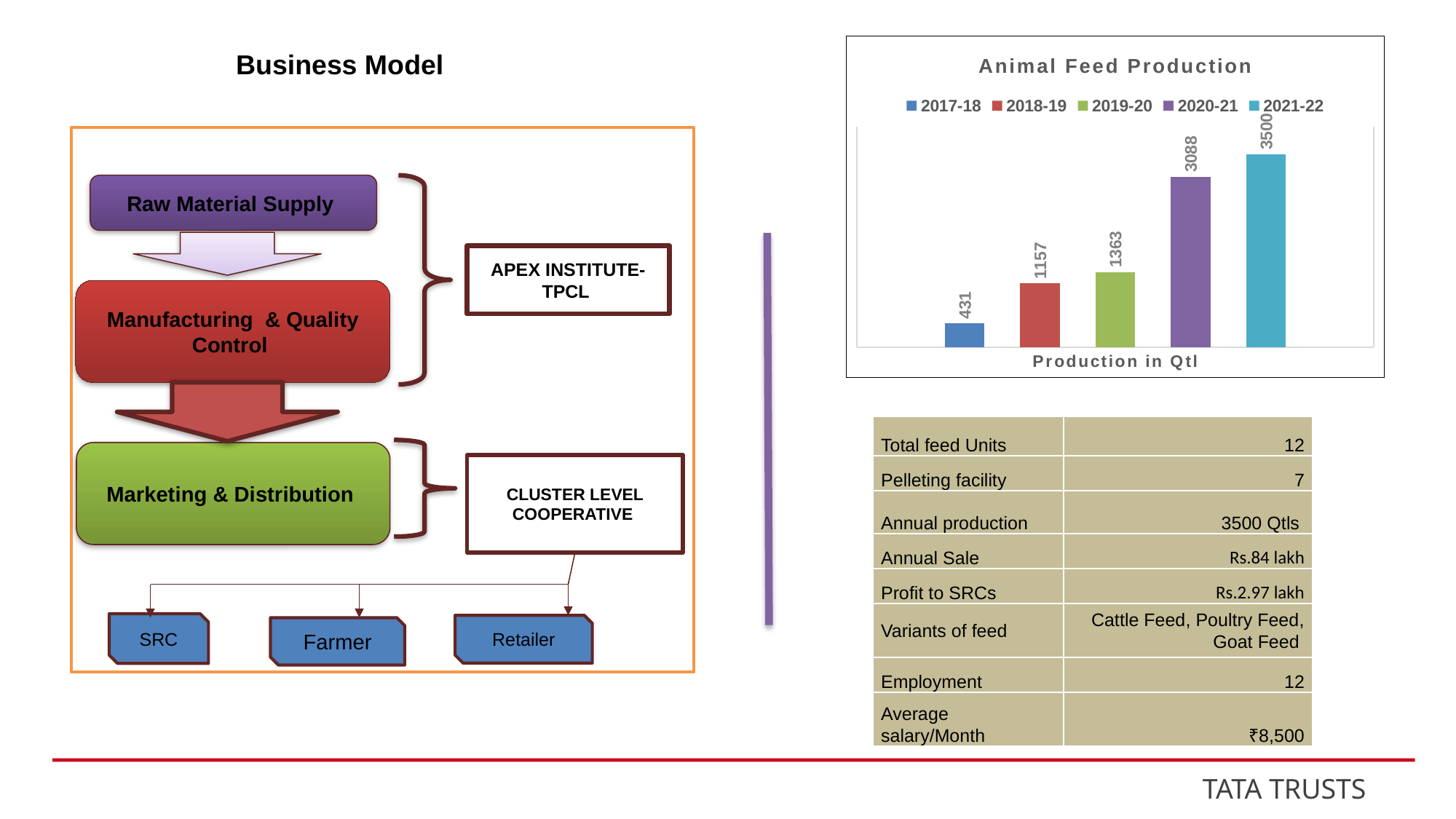
Which year has the lowest production in the Animal Feed Production chart? 2017-18 What is the production value for 2019-20 in the Animal Feed Production chart? 1363 Which year has the highest production in the Animal Feed Production chart? 2021-22 Which is larger in the Animal Feed Production chart, the value for 2018-19 or 2019-20? 2019-20 What is the difference in production between 2019-20 and 2018-19 in the Animal Feed Production chart? 206 Do the production values rise or fall from 2017-18 to 2021-22 in the Animal Feed Production chart? rise What kind of chart is the Animal Feed Production chart? bar chart What is the production value for 2020-21 in the Animal Feed Production chart? 3088 How many series does the legend of the Animal Feed Production chart list? 5 What is the difference in production between 2021-22 and 2020-21 in the Animal Feed Production chart? 412 What is the production value for 2017-18 in the Animal Feed Production chart? 431 How many years are plotted in the Animal Feed Production chart? 5